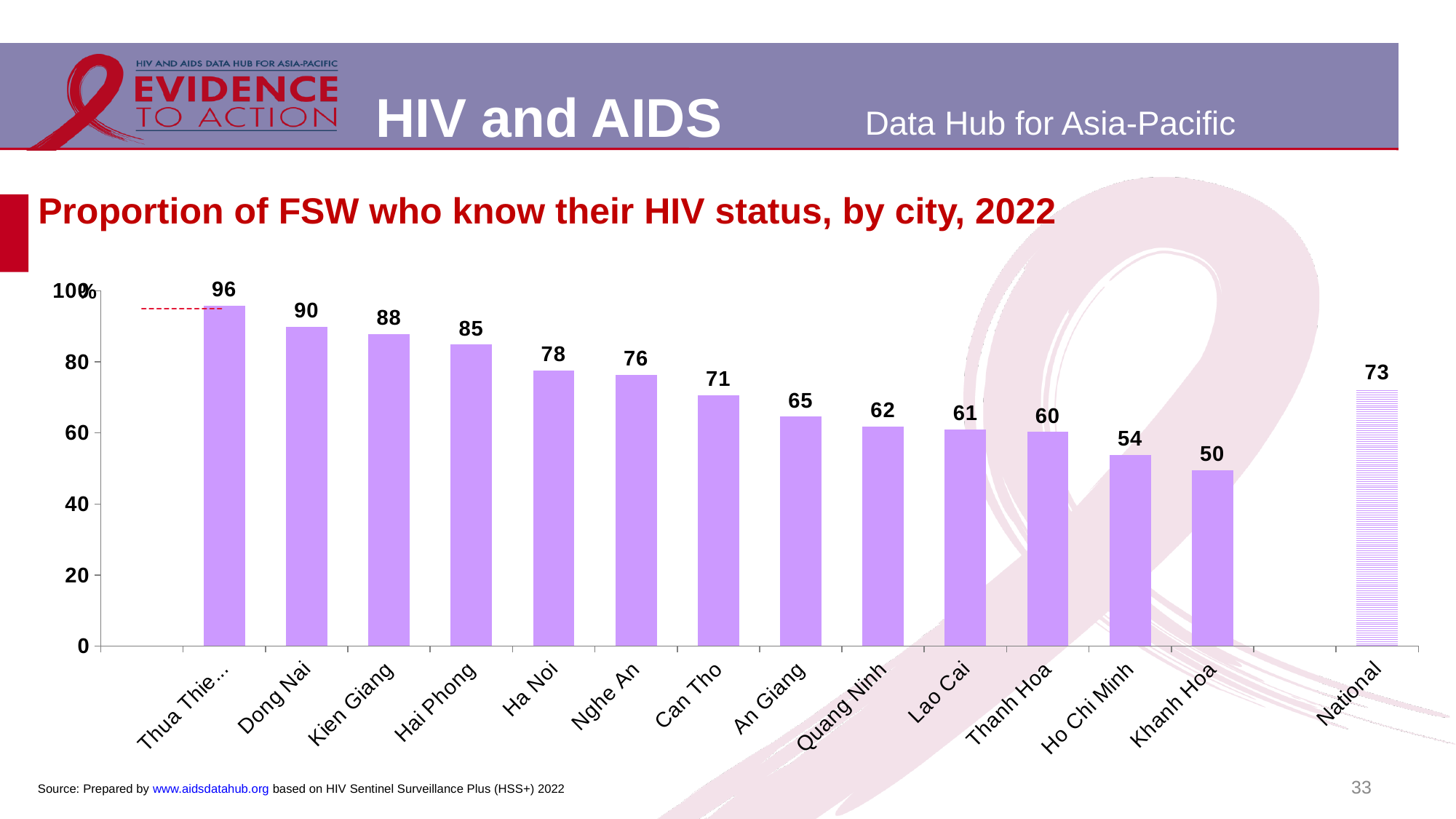
What is the value for Ha Noi? 78 Which is larger, the value for Can Tho or the value for An Giang? Can Tho What is the National value shown on the chart? 73 Is the value for Nghe An greater or less than the National value? greater What is the difference between the values for Dong Nai and Kien Giang? 2 What is the highest value shown on the chart? 96 Do the city values rise or fall from left to right across the chart (excluding National)? Fall What kind of chart is shown on the slide? Bar chart How many bars are plotted on the chart, including National? 14 What is the value for Ho Chi Minh? 54 Which city has the lowest proportion of FSW who know their HIV status? Khanh Hoa What is the difference between the values for Hai Phong and Khanh Hoa? 35